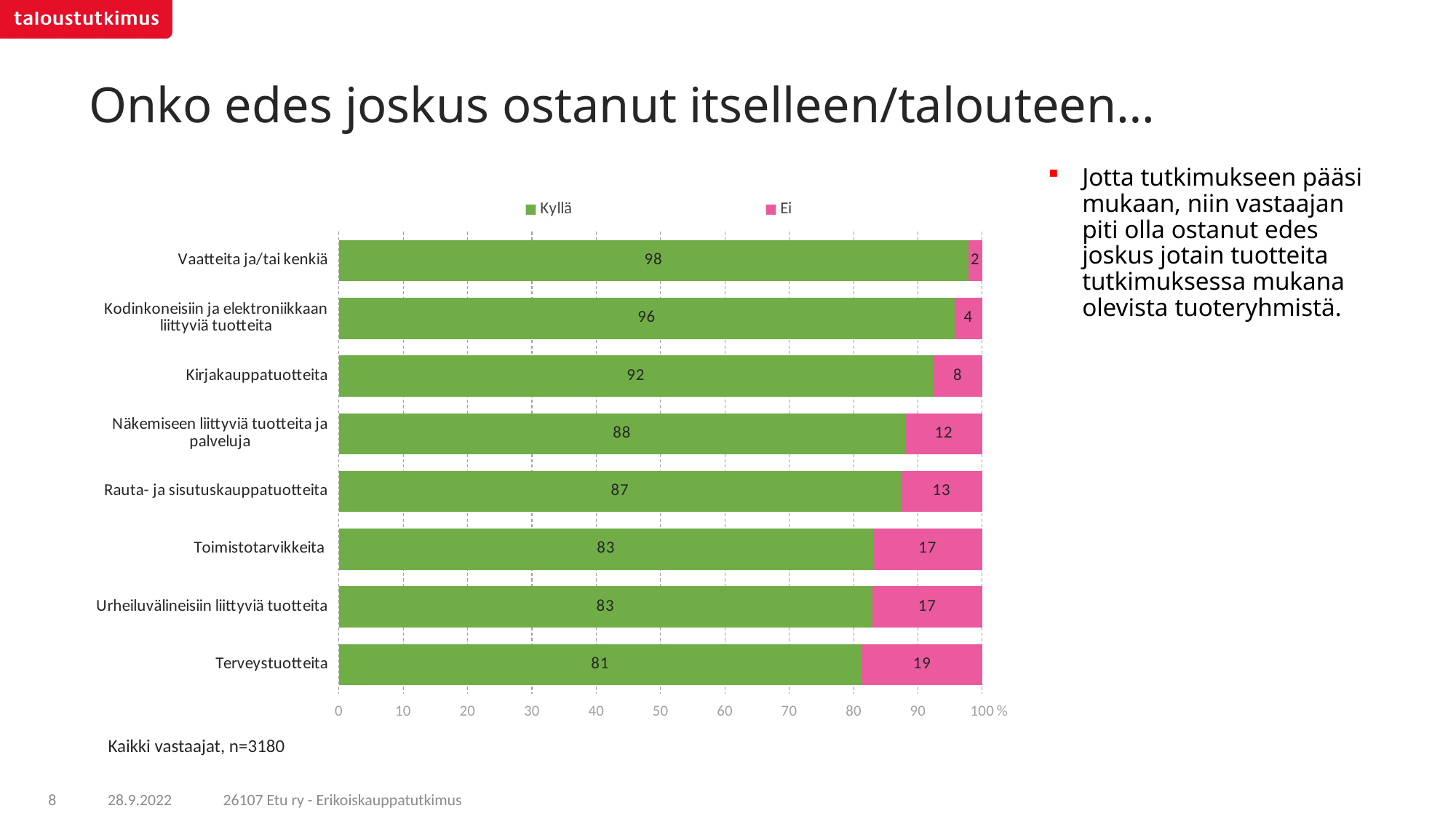
What is the Ei value for Näkemiseen liittyviä tuotteita ja palveluja? 12 Which category has the highest Kyllä value? Vaatteita ja/tai kenkiä Which is larger, the Ei value for Rauta- ja sisutuskauppatuotteita or the Ei value for Kirjakauppatuotteita? Rauta- ja sisutuskauppatuotteita Which colour represents the Ei series in the chart? Pink What is the difference between the Kyllä values for Vaatteita ja/tai kenkiä and Terveystuotteita? 17 How many series does the legend list? 2 What is the Kyllä value for Kirjakauppatuotteita? 92 What kind of chart is shown on the slide? Stacked bar chart What is the total of the stacked bar for Toimistotarvikkeita? 100 How many categories are shown in the chart? 8 What is the Ei value for Terveystuotteita? 19 Which category has the lowest Kyllä value? Terveystuotteita